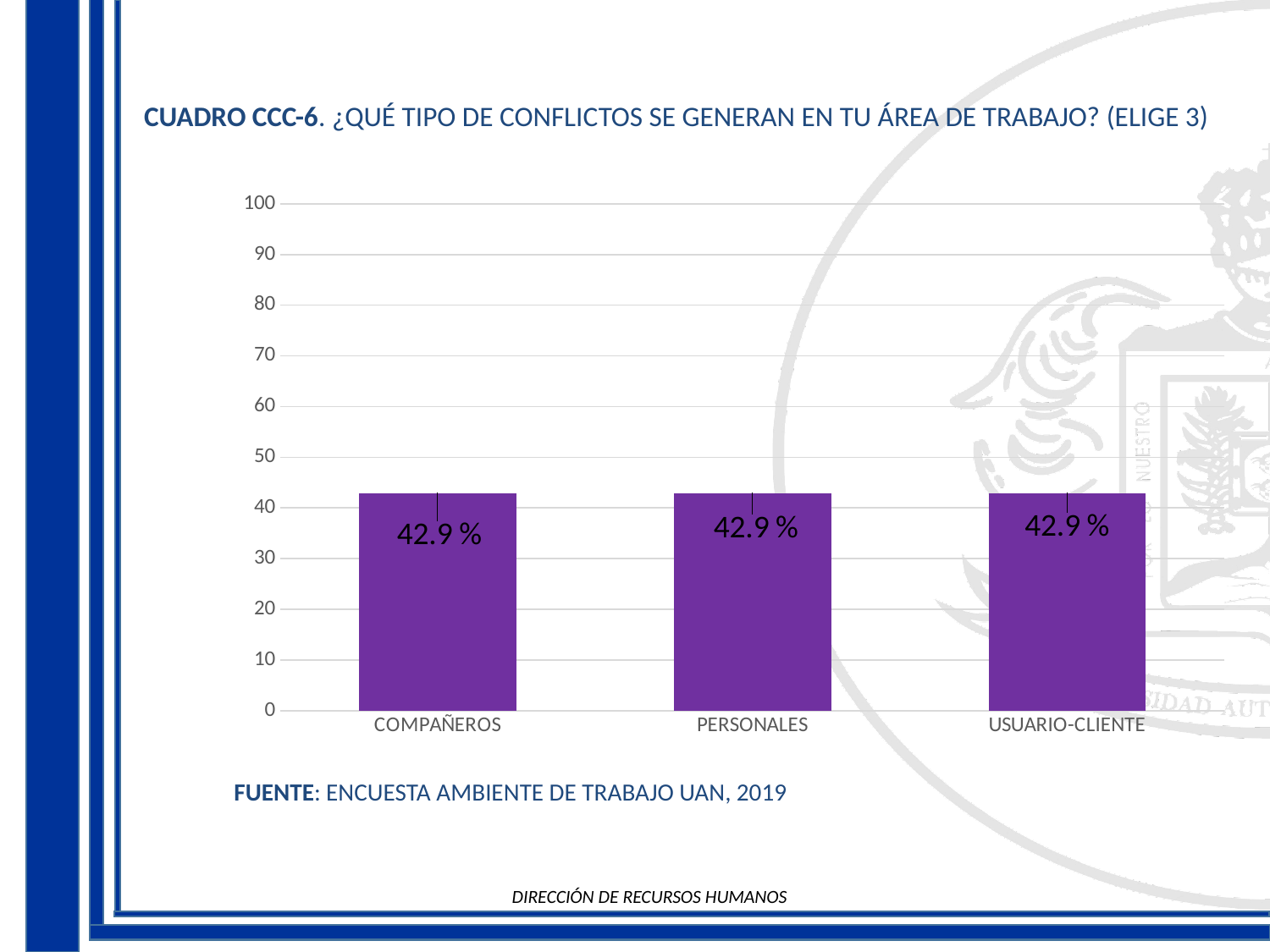
What is the value for PERSONALES? 42.9 % What is the value for USUARIO-CLIENTE? 42.9 % Is the value for USUARIO-CLIENTE greater or less than 40? greater What is the difference between the values for PERSONALES and COMPAÑEROS? 0 Is the value for COMPAÑEROS greater or less than 50? less What is the value for COMPAÑEROS? 42.9 % What is the highest value shown on the y axis? 100 What source is cited below the chart? ENCUESTA AMBIENTE DE TRABAJO UAN, 2019 How many categories are shown on the x axis? 3 What kind of chart is shown on the slide? bar chart Do the values rise, fall, or stay the same from COMPAÑEROS to USUARIO-CLIENTE? stay the same